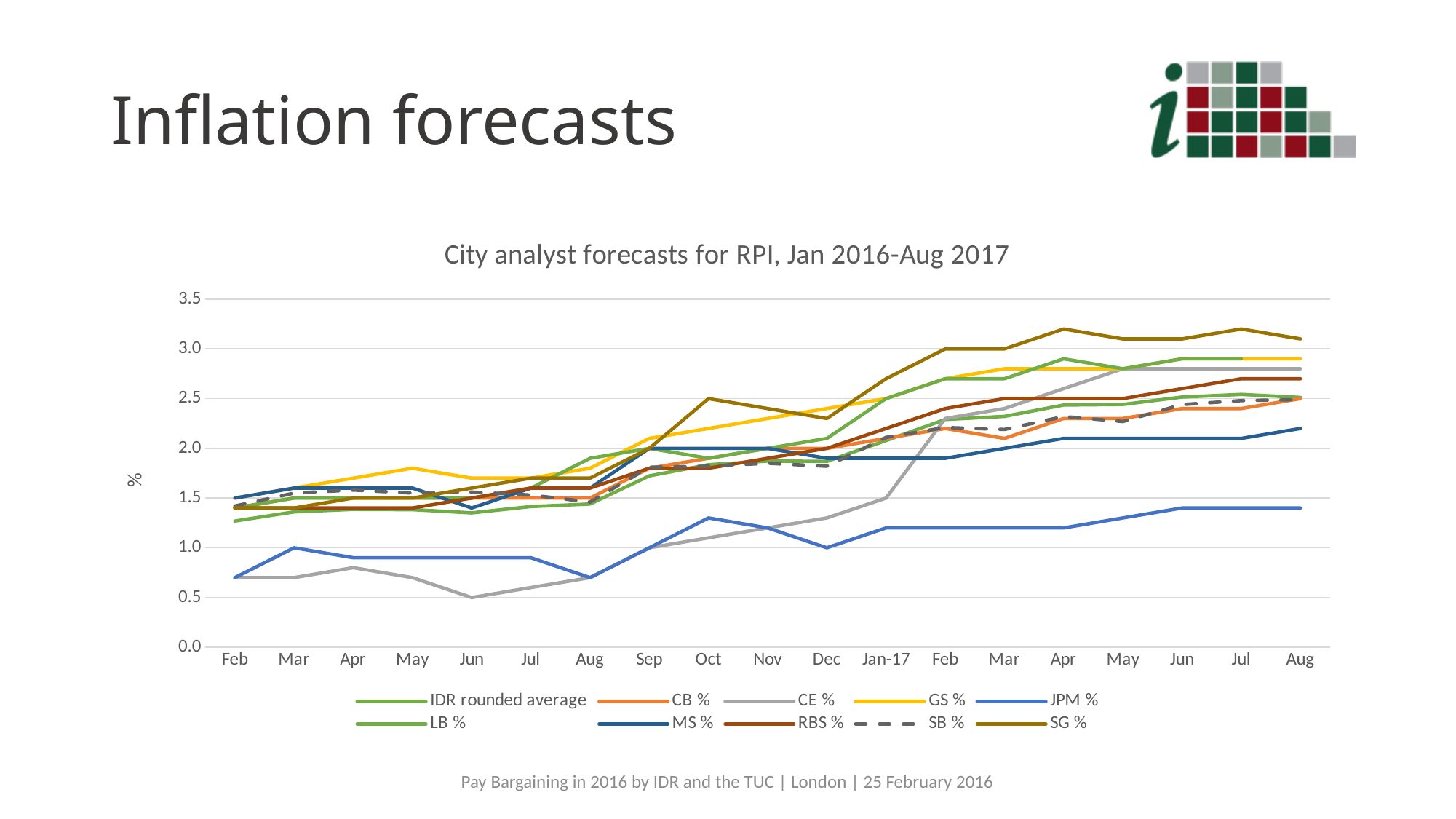
What is the title of the chart? City analyst forecasts for RPI, Jan 2016-Aug 2017 Does the SG % series generally rise or fall from Feb 2016 to Aug 2017? rise Is the value for MS % at Aug 2017 greater or less than 2.0? greater What kind of chart is shown on the slide? line chart How many series does the legend list? 10 Which series has the lowest value at Jun 2016? CE % How many months are shown along the x axis? 19 Which series has the highest value at Aug 2017? SG % Which series has the lowest value at Aug 2017? JPM % Is the value for JPM % at Aug 2017 greater or less than 1.5? less Is the value for SG % at Apr 2017 greater or less than 3.0? greater At Aug 2017, which is larger: GS % or MS %? GS %